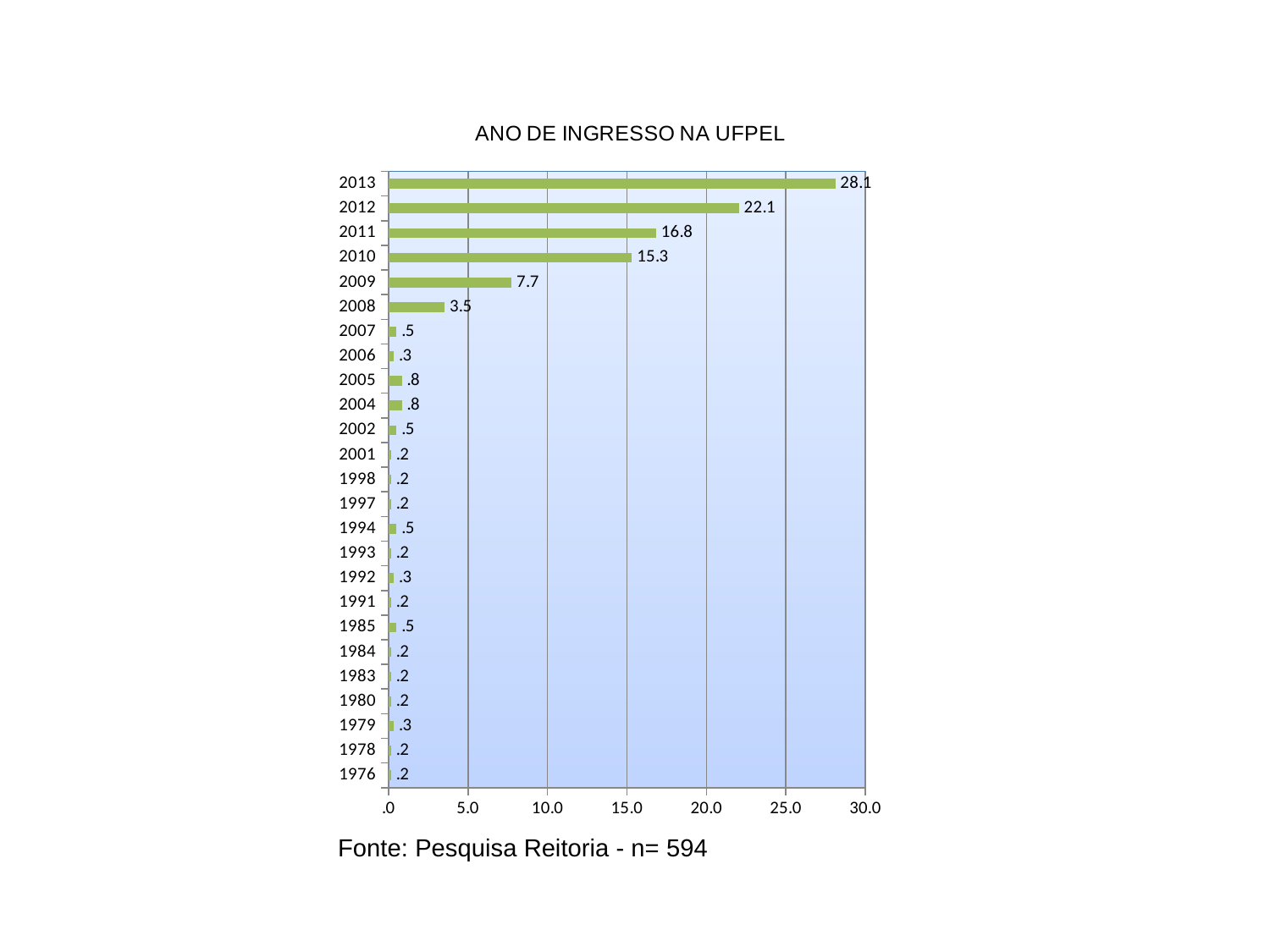
How many years are shown on the chart? 25 What is the value for 2010? 15.3 Is the value for 2012 greater or less than 20.0? greater What is the difference between the values for 2013 and 2012? 6.0 What is the value for 2013? 28.1 What is the title of the chart? ANO DE INGRESSO NA UFPEL What is the difference between the values for 2011 and 2010? 1.5 Which year has the highest value? 2013 What kind of chart is this? Bar chart What is the value for 2008? 3.5 Which is larger, the value for 2009 or the value for 2008? 2009 What is the value for 2005? .8